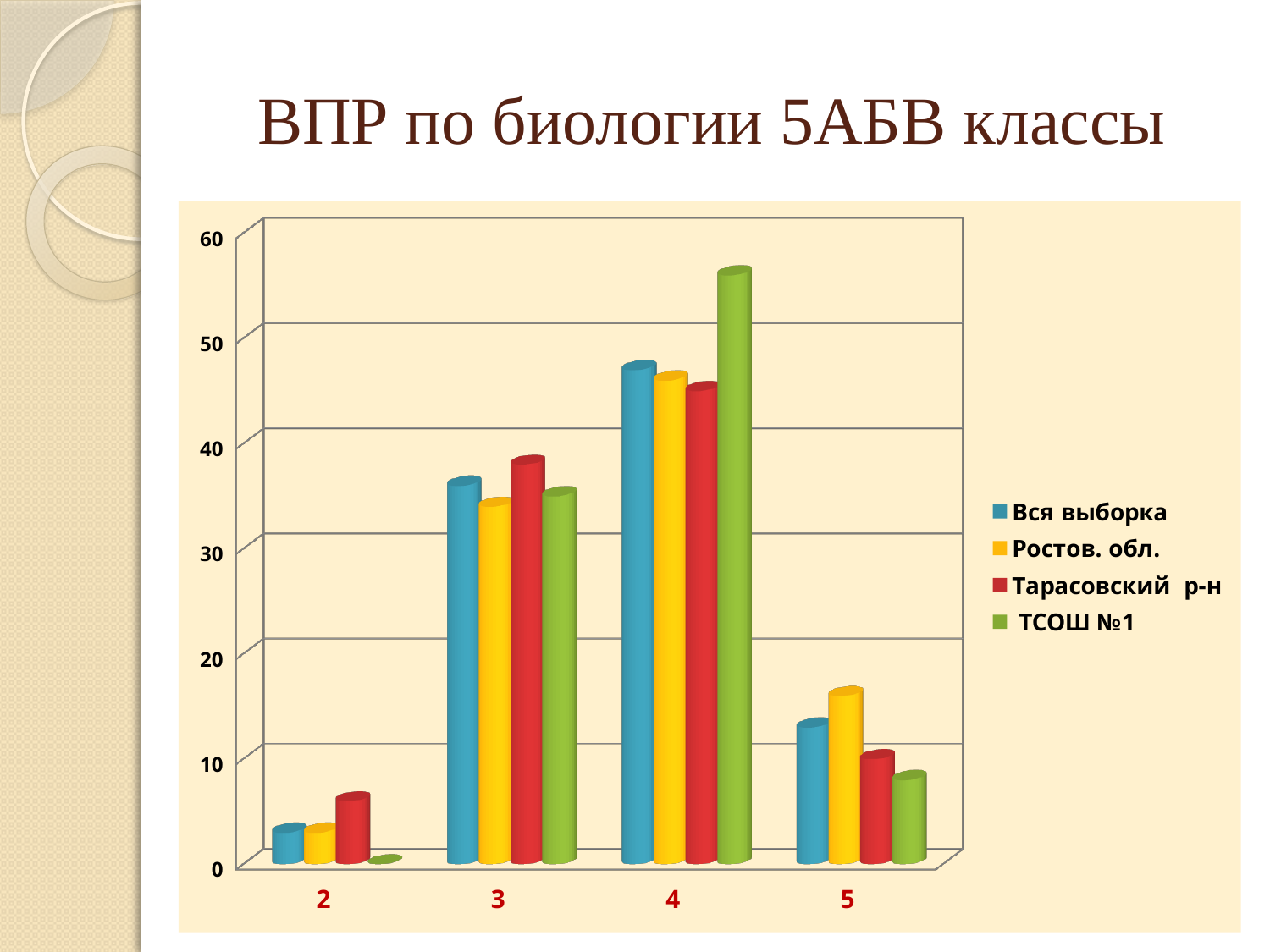
What kind of chart is shown on the slide? bar chart In category 4, which series has the highest value? ТСОШ №1 How many series does the legend list? 4 For the series ТСОШ №1, which category has the lowest value? 2 Is the value for Вся выборка in category 2 greater or less than 10? less In category 5, which is larger: Ростов. обл. or Вся выборка? Ростов. обл. Is the value for ТСОШ №1 in category 4 greater or less than 50? greater In category 3, which is larger: Тарасовский р-н or Ростов. обл.? Тарасовский р-н What is the title of the slide? ВПР по биологии 5АБВ классы For the series ТСОШ №1, which category has the highest value? 4 How many categories are shown on the x axis of the chart? 4 In category 2, which series has the lowest value? ТСОШ №1